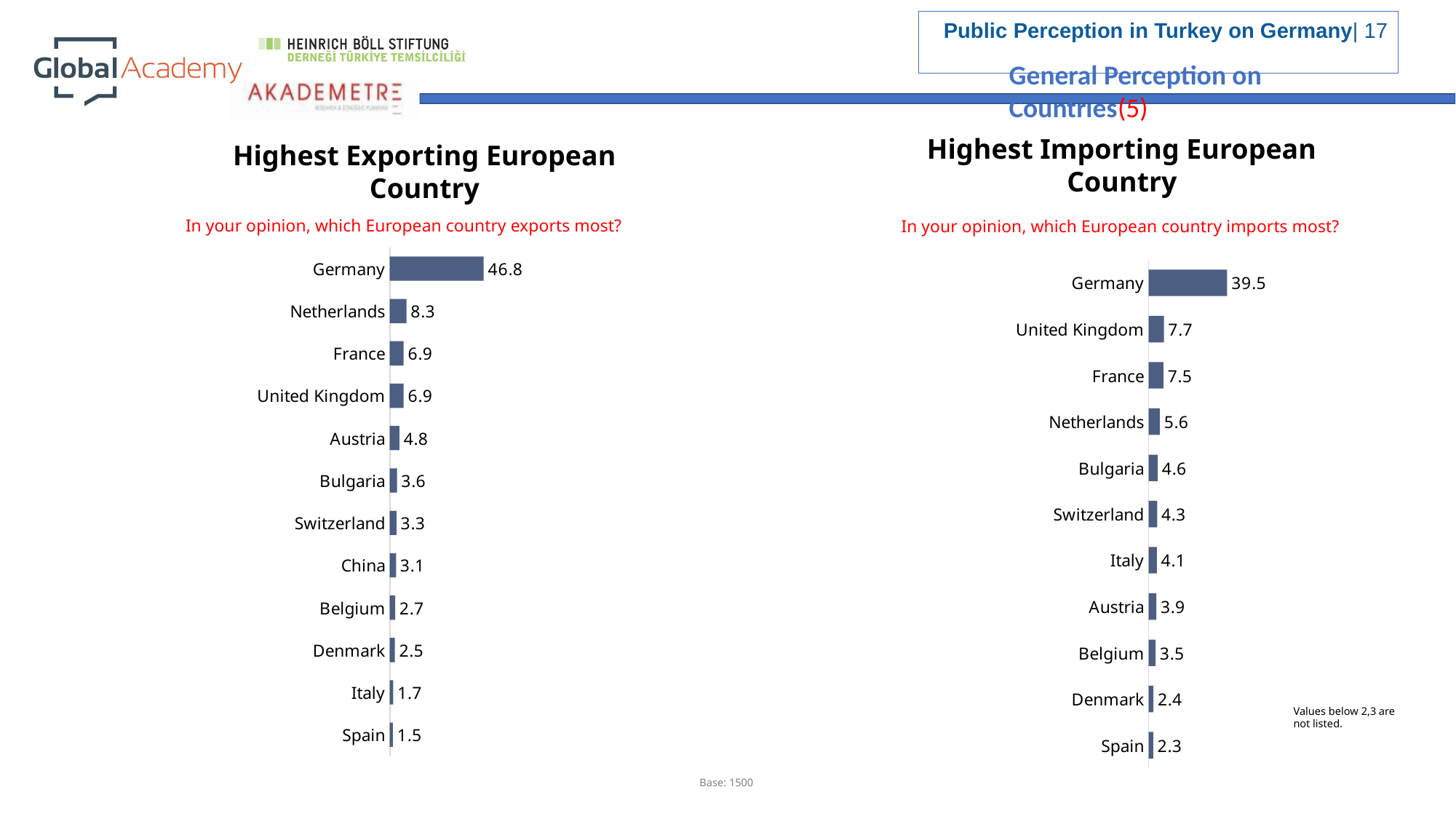
In the 'Highest Exporting European Country' chart, what is the value for China? 3.1 How many countries are listed in the 'Highest Importing European Country' chart? 11 In the 'Highest Importing European Country' chart, what is the difference between Germany and France? 32.0 How many countries are listed in the 'Highest Exporting European Country' chart? 12 In the 'Highest Exporting European Country' chart, which is larger, the value for Austria or the value for Belgium? Austria What kind of chart is the 'Highest Importing European Country' chart? Bar chart In the 'Highest Exporting European Country' chart, which country has the highest value? Germany In the 'Highest Exporting European Country' chart, what is the value for Germany? 46.8 In the 'Highest Importing European Country' chart, which is larger, the value for Bulgaria or the value for Italy? Bulgaria In the 'Highest Importing European Country' chart, what is the value for United Kingdom? 7.7 In the 'Highest Exporting European Country' chart, what is the difference between Germany and Netherlands? 38.5 In the 'Highest Importing European Country' chart, which country has the lowest value? Spain